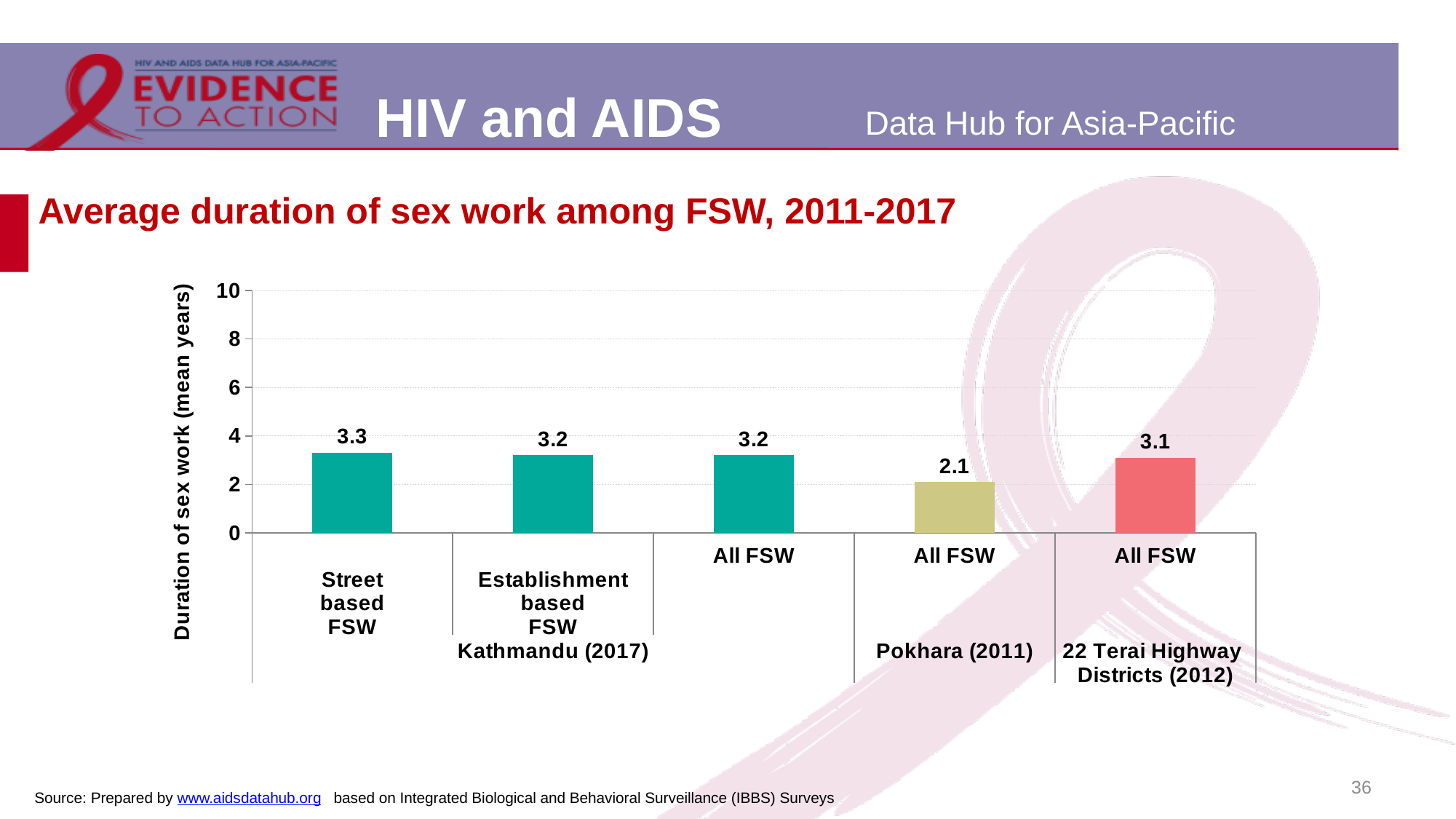
What is the difference between the average duration for all FSW in Kathmandu (2017) and all FSW in Pokhara (2011)? 1.1 Which is larger: the average duration for all FSW in the 22 Terai Highway Districts (2012) or all FSW in Pokhara (2011)? 22 Terai Highway Districts (2012) What is the label of the vertical axis? Duration of sex work (mean years) What is the average duration of sex work for establishment based FSW in Kathmandu (2017)? 3.2 Which bar shows the lowest average duration of sex work? All FSW, Pokhara (2011) What is the average duration of sex work for street based FSW in Kathmandu (2017)? 3.3 Is the value for all FSW in Pokhara (2011) greater or less than 4? less What is the average duration of sex work for all FSW in the 22 Terai Highway Districts (2012)? 3.1 What type of chart is shown on the slide? Bar chart What is the average duration of sex work for all FSW in Pokhara (2011)? 2.1 How many bars are plotted in the chart? 5 Which bar shows the highest average duration of sex work? Street based FSW, Kathmandu (2017)